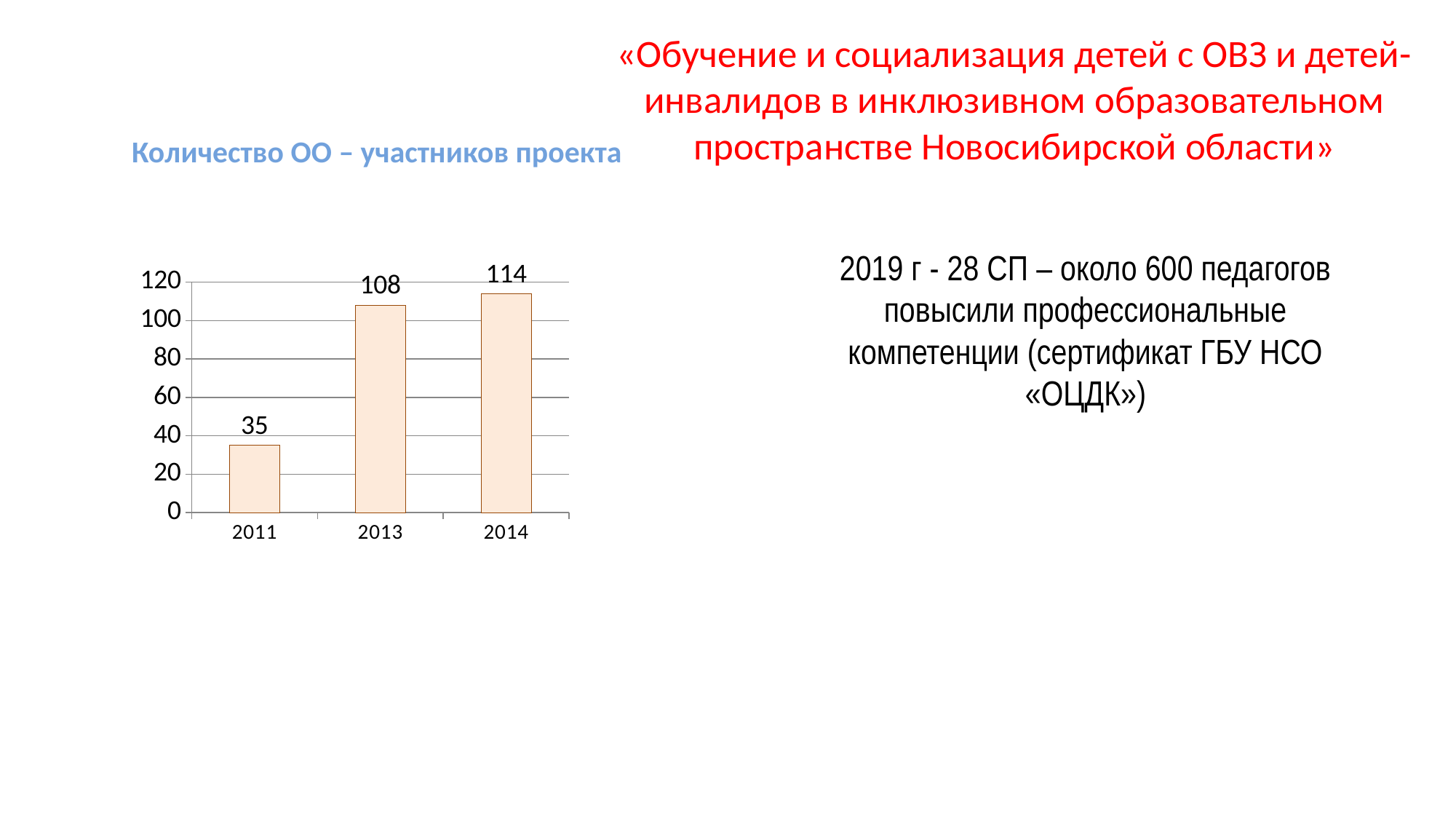
Which is larger, the value for 2013 or the value for 2011? 2013 What is the value for 2014? 114 What is the value for 2011? 35 What kind of chart is shown? bar chart Which year has the lowest value? 2011 Do the values rise or fall from 2011 to 2014? rise How many years are shown on the x axis? 3 What is the difference between the values for 2014 and 2011? 79 What is the value for 2013? 108 What is the difference between the values for 2013 and 2011? 73 Is the value for 2011 greater or less than 40? less Which year has the highest value? 2014